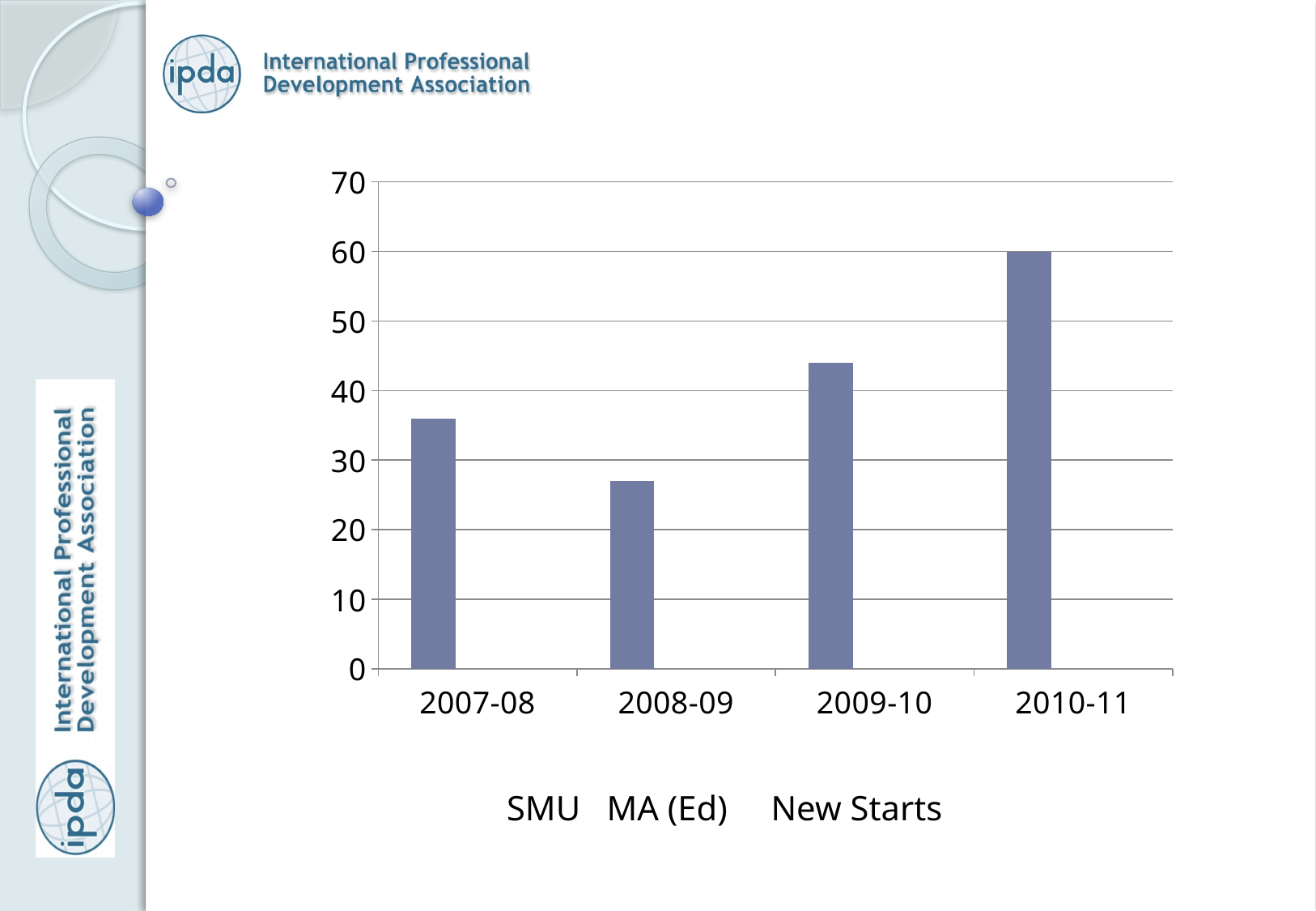
Do the values rise or fall from 2008-09 to 2010-11? rise Is the value for 2007-08 greater or less than 30? greater Which year has the highest number of SMU MA (Ed) new starts? 2010-11 Which year has more new starts, 2007-08 or 2009-10? 2009-10 How many academic years are shown on the x axis of the chart? 4 What kind of chart is shown on the slide? bar chart What is the value for 2010-11 in the chart? 60 Is the value for 2008-09 greater or less than 30? less Which year has the lowest number of SMU MA (Ed) new starts? 2008-09 What is the caption shown below the chart? SMU MA (Ed) New Starts Is the value for 2009-10 greater or less than 40? greater Which year has more new starts, 2008-09 or 2010-11? 2010-11